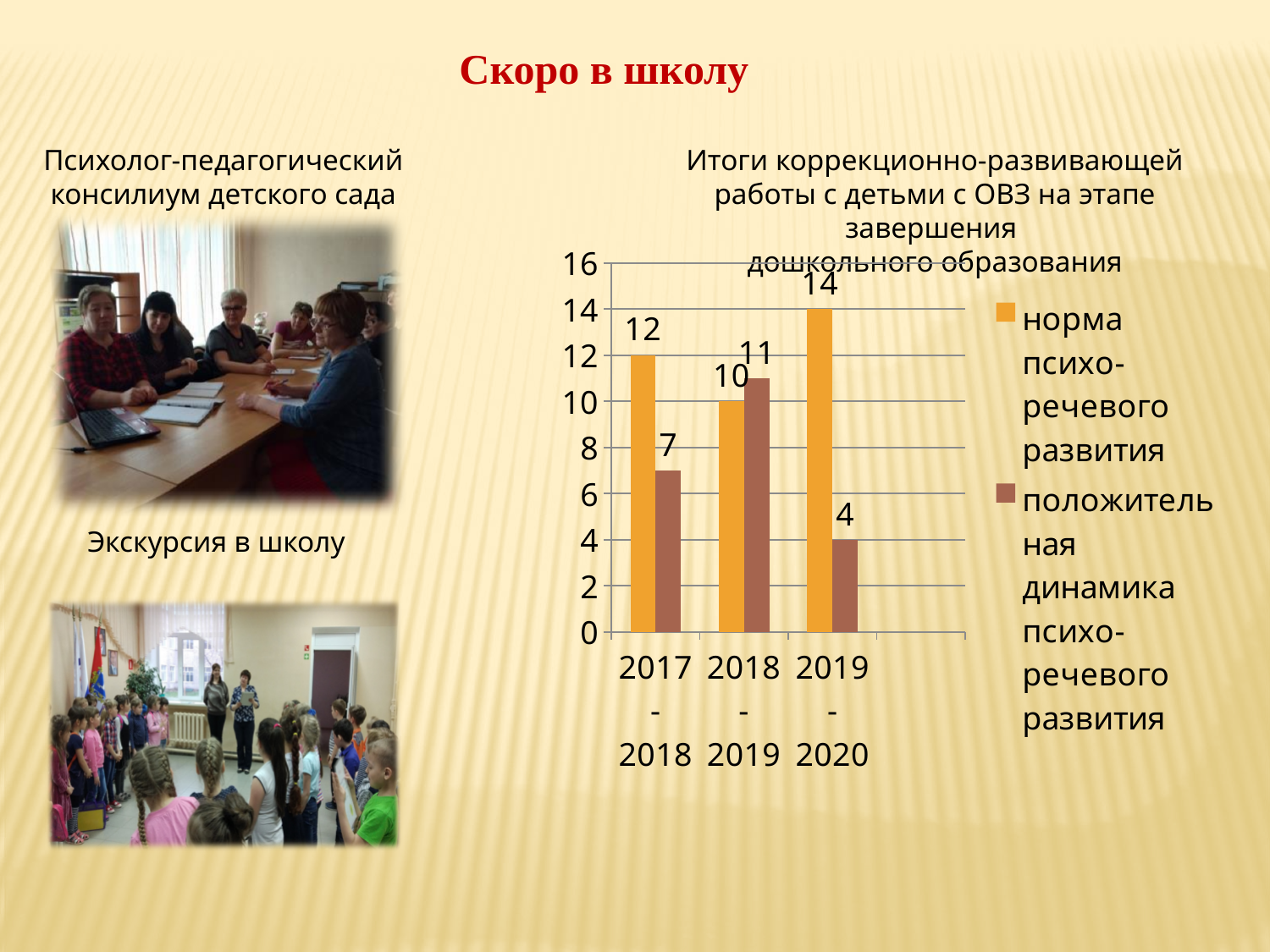
What is the value for 'норма психо-речевого развития' in 2019-2020? 14 Does the value for 'положительная динамика психо-речевого развития' rise or fall from 2018-2019 to 2019-2020? fall What type of chart is shown on the slide? bar chart What is the value for 'норма психо-речевого развития' in 2017-2018? 12 How many year-period categories are shown on the x axis of the chart? 3 How many series does the chart legend list? 2 What is the difference between 'норма психо-речевого развития' and 'положительная динамика психо-речевого развития' in 2019-2020? 10 What colour are the bars for 'норма психо-речевого развития'? orange What is the value for 'положительная динамика психо-речевого развития' in 2018-2019? 11 In which period is the value for 'норма психо-речевого развития' the highest? 2019-2020 In 2018-2019, which series has the larger value: 'норма психо-речевого развития' or 'положительная динамика психо-речевого развития'? положительная динамика психо-речевого развития In which period is the value for 'положительная динамика психо-речевого развития' the lowest? 2019-2020